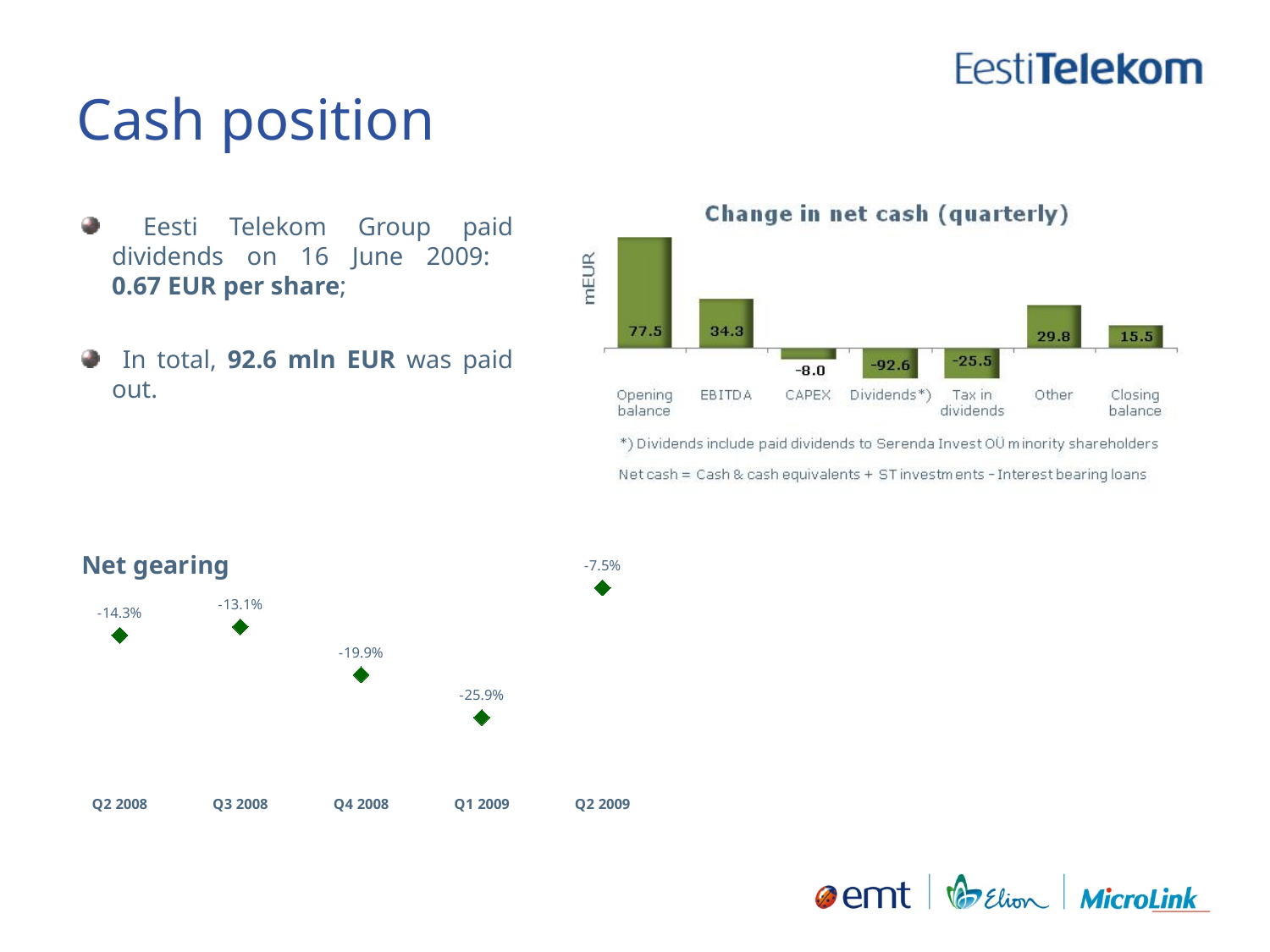
In the 'Change in net cash (quarterly)' chart, what is the Closing balance? 15.5 In the 'Net gearing' chart, how many quarters are plotted? 5 In the 'Change in net cash (quarterly)' chart, what is the difference between the Opening balance and the Closing balance? 62.0 What type of chart is 'Change in net cash (quarterly)'? Bar chart In the 'Change in net cash (quarterly)' chart, what is the value for Dividends*)? -92.6 In the 'Change in net cash (quarterly)' chart, what is the value for EBITDA? 34.3 In the 'Net gearing' chart, what is the value for Q1 2009? -25.9% In the 'Net gearing' chart, which quarter has the lowest value? Q1 2009 In the 'Change in net cash (quarterly)' chart, which category has the highest value? Opening balance In the 'Change in net cash (quarterly)' chart, how many categories are shown on the x axis? 7 In the 'Change in net cash (quarterly)' chart, which category has the lowest value? Dividends*) In the 'Net gearing' chart, what is the value for Q2 2009? -7.5%